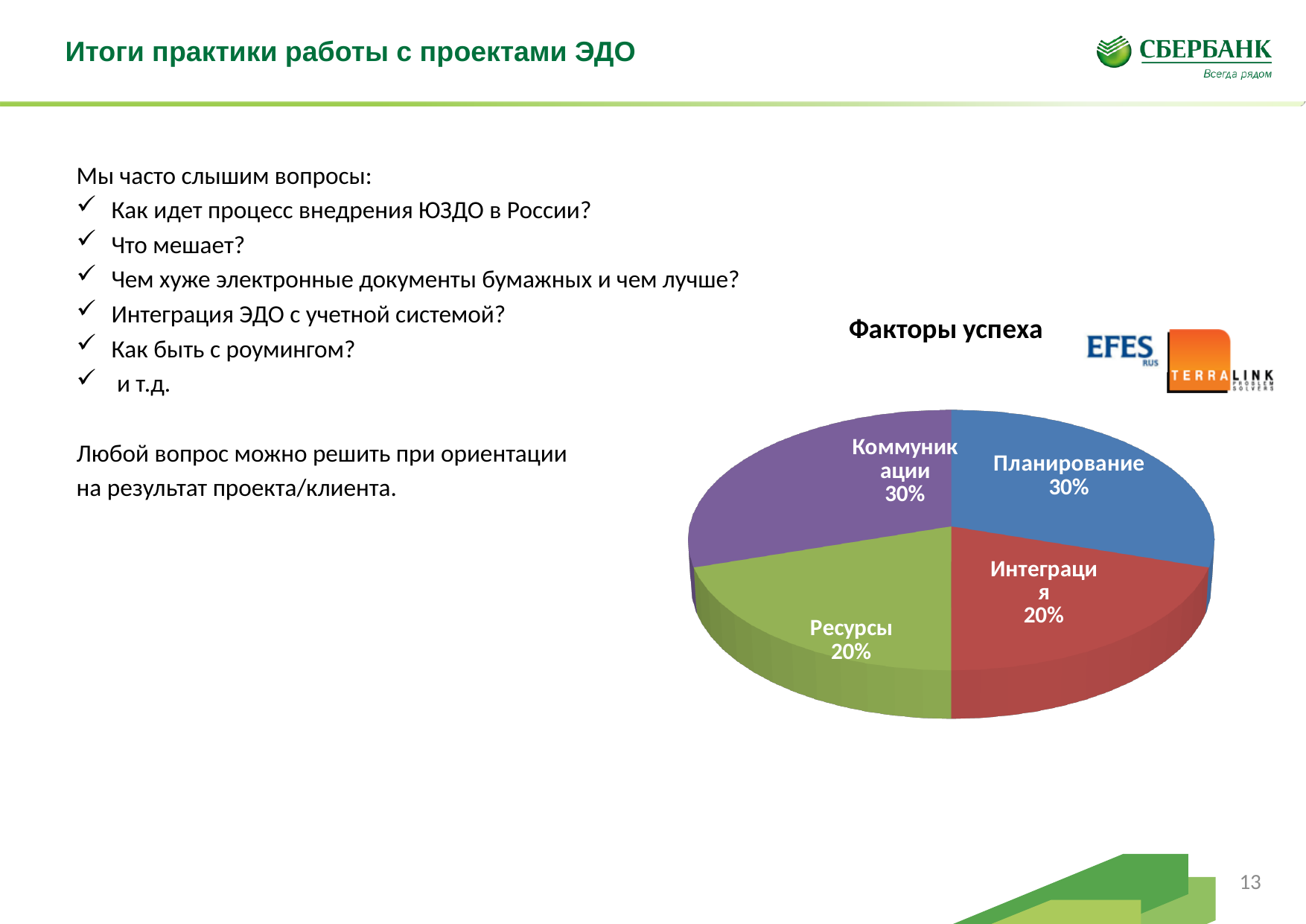
How many slices does the pie chart have? 4 What share of the pie does Коммуникации have? 30% What is the difference between the share for Коммуникации and the share for Ресурсы? 10% What kind of chart is shown on the slide? Pie chart Which is larger, the share for Планирование or the share for Интеграция? Планирование Which is larger, the share for Ресурсы or the share for Коммуникации? Коммуникации Which two categories share the largest value in the pie chart? Планирование and Коммуникации What share of the pie does Планирование have? 30% What share of the pie does Интеграция have? 20% What colour is the Ресурсы slice of the pie chart? Green What is the title of the pie chart? Факторы успеха